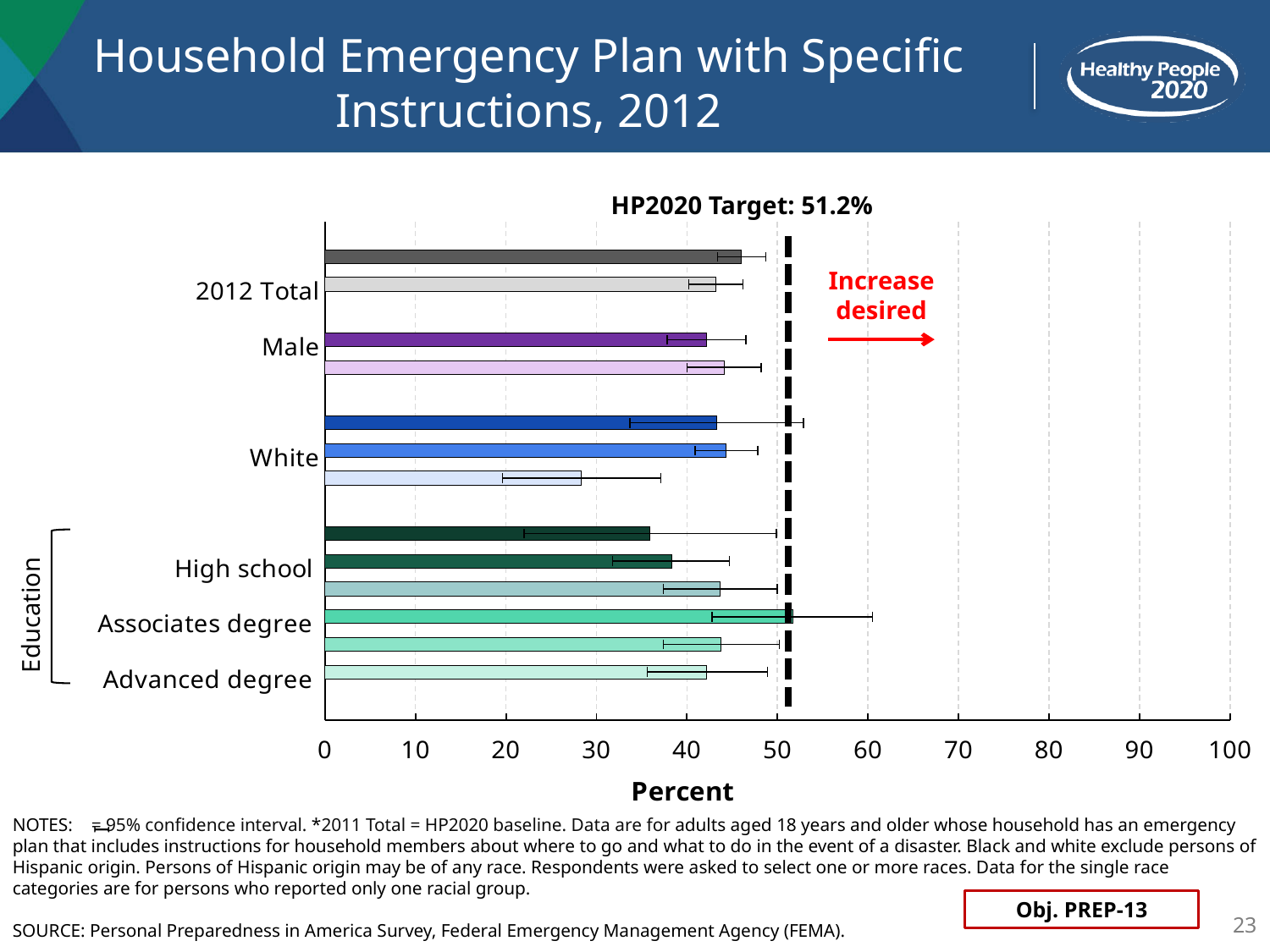
Which labeled category has the longest bar on the chart? Associates degree Is the value for Male greater or less than 50? less According to the annotation on the chart, in which direction is change desired? Increase desired Is the value for White greater or less than 50? less What is the title of the x axis? Percent Which is larger, the value for 2012 Total or the value for High school? 2012 Total Is the value for Advanced degree greater or less than 50? less Which is larger, the value for Associates degree or the value for Advanced degree? Associates degree What is the HP2020 Target value shown on the chart? 51.2% What kind of chart is shown on the slide? bar chart